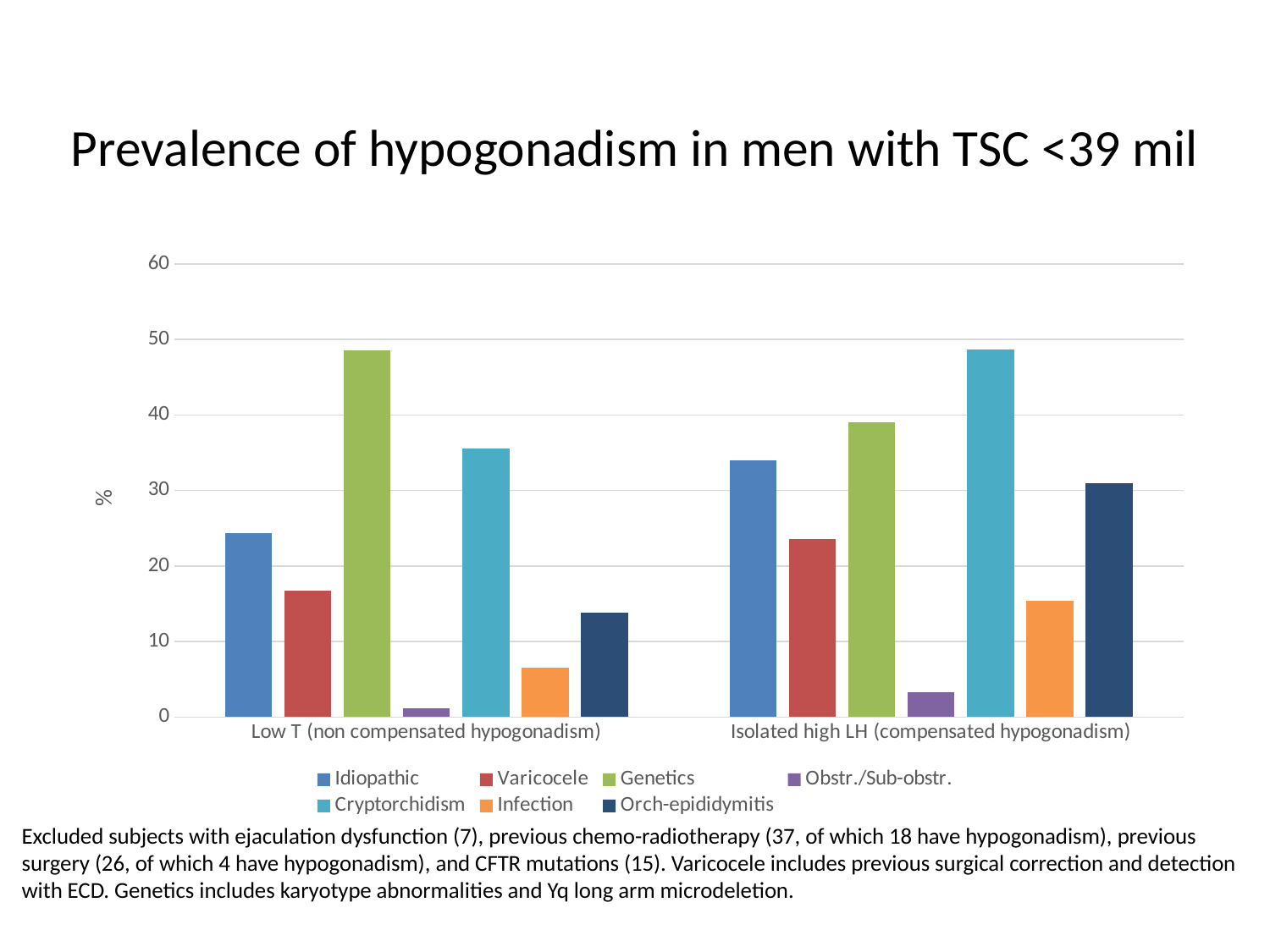
Which series has the lowest value in the Isolated high LH (compensated hypogonadism) group? Obstr./Sub-obstr. Which group has the larger Cryptorchidism value: Low T (non compensated hypogonadism) or Isolated high LH (compensated hypogonadism)? Isolated high LH (compensated hypogonadism) How many categories are shown on the x axis? 2 Is the Genetics value for Low T (non compensated hypogonadism) greater or less than 40? greater Is the Idiopathic value for Isolated high LH (compensated hypogonadism) greater or less than 30? greater What kind of chart is shown on the slide? bar chart What is the label on the vertical axis of the chart? % How many series does the legend list? 7 Which series has the highest value in the Isolated high LH (compensated hypogonadism) group? Cryptorchidism Which series has the lowest value in the Low T (non compensated hypogonadism) group? Obstr./Sub-obstr. Which series has the highest value in the Low T (non compensated hypogonadism) group? Genetics Is the Infection value for Low T (non compensated hypogonadism) greater or less than 10? less